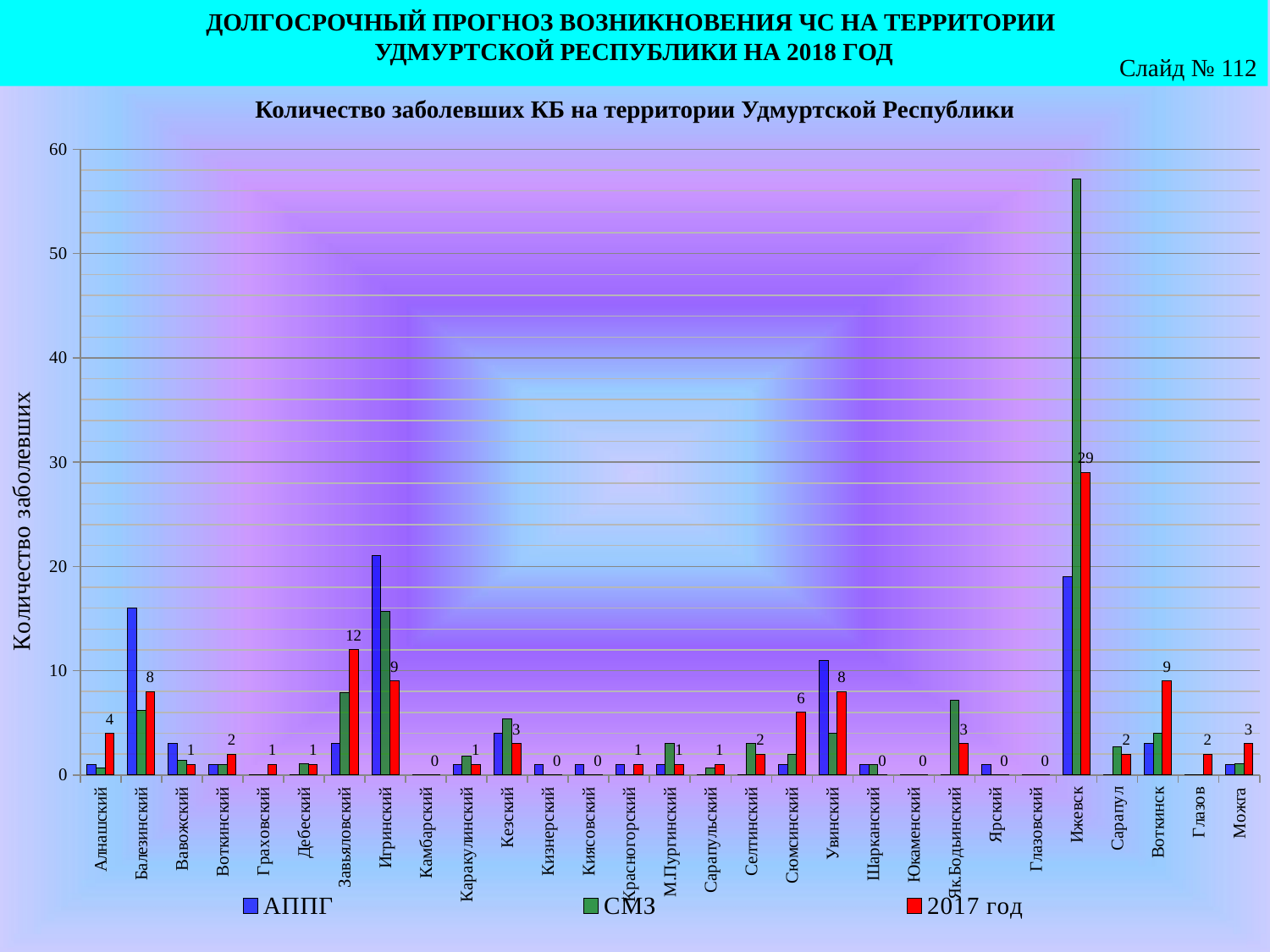
What is the difference between the 2017 год values for Ижевск and Увинский? 21 What is the title of the chart? Количество заболевших КБ на территории Удмуртской Республики What is the value for Завьяловский in the 2017 год series? 12 What type of chart is shown on the slide? bar chart Is the АППГ value for Балезинский greater or less than 10? greater Is the СМЗ value for Ижевск greater or less than 50? greater Which is larger in the 2017 год series: Воткинск or Сарапул? Воткинск Which category has the highest value in the 2017 год series? Ижевск How many series does the legend list? 3 What is the value for Ижевск in the 2017 год series? 29 What is the value for Сюмсинский in the 2017 год series? 6 What is the difference between the 2017 год values for Завьяловский and Игринский? 3